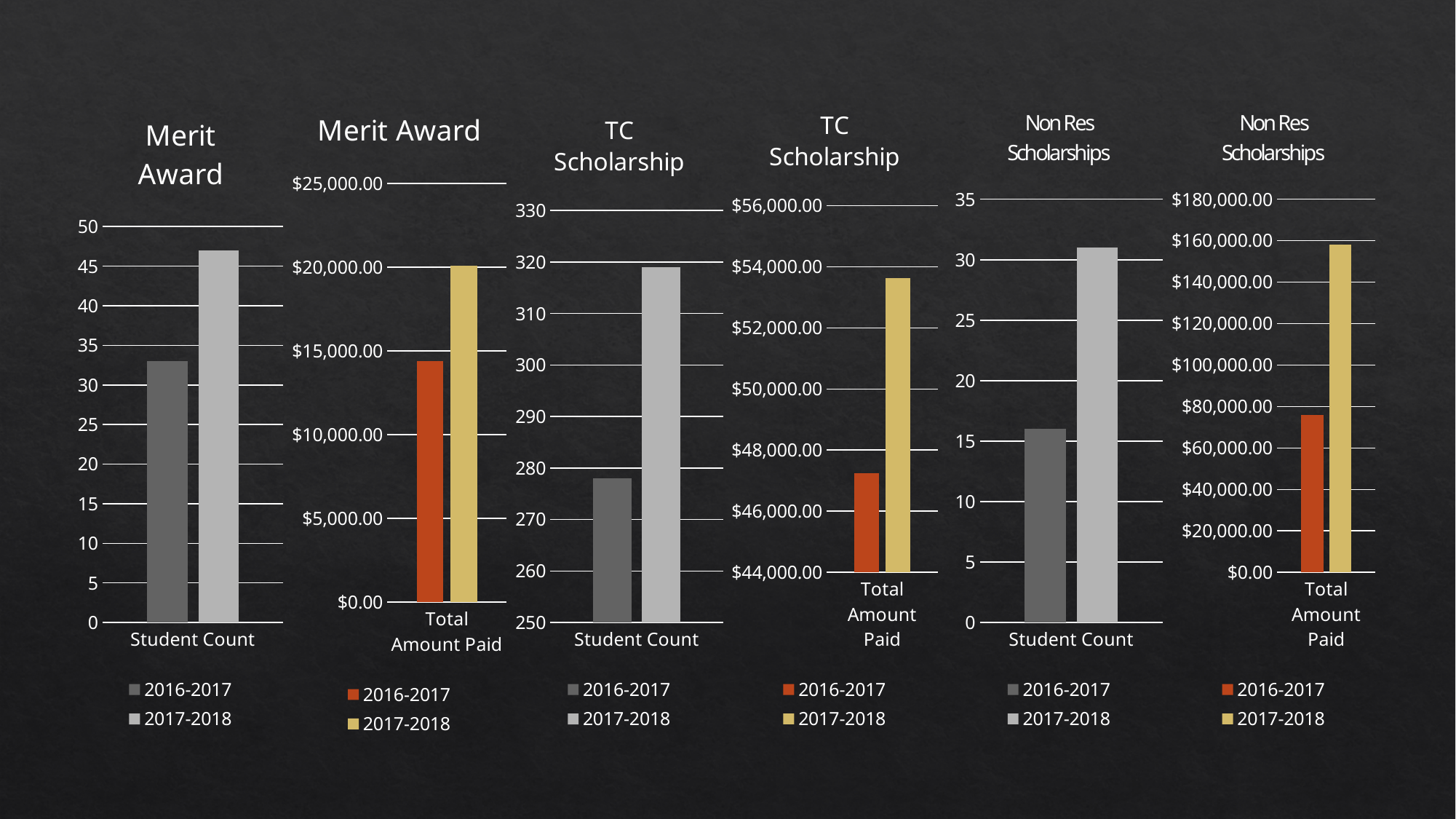
How many series does the legend of the Non Res Scholarships Total Amount Paid chart list? 2 In the Non Res Scholarships Total Amount Paid chart, is the value for 2016-2017 greater or less than $80,000.00? less In the leftmost Merit Award chart (Student Count), is the value for 2016-2017 greater or less than 35? less In the Merit Award Total Amount Paid chart, is the value for 2016-2017 greater or less than $15,000.00? less What kind of chart is the TC Scholarship Student Count chart? bar chart In the Merit Award Total Amount Paid chart, which series has the larger value, 2016-2017 or 2017-2018? 2017-2018